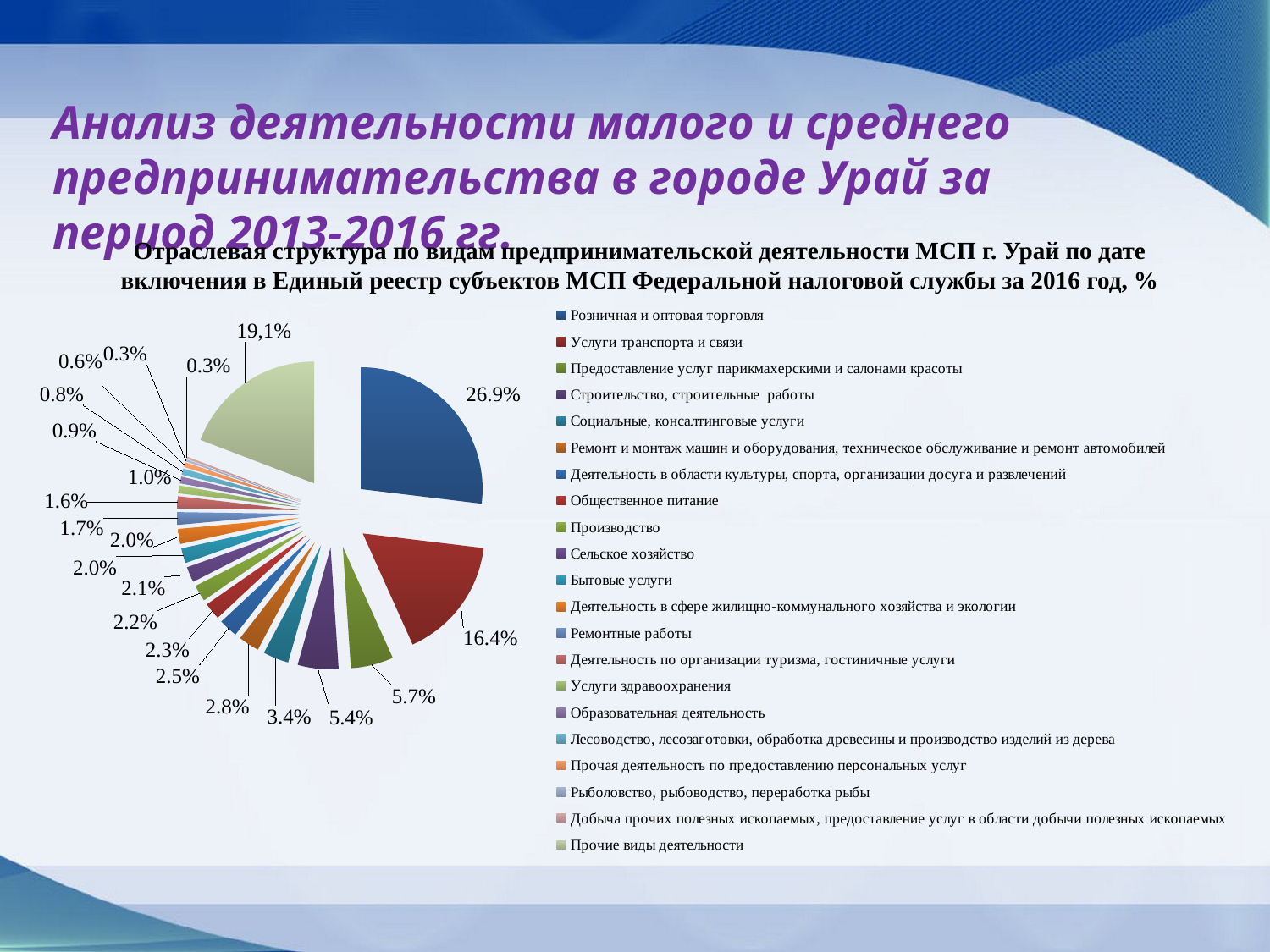
Which is larger: the slice for "Услуги транспорта и связи" or the slice for "Прочие виды деятельности"? Прочие виды деятельности What is the difference in percentage points between the slices for "Розничная и оптовая торговля" and "Услуги транспорта и связи"? 10.5 What share of the pie does "Строительство, строительные работы" have? 5.4% What share of the pie does "Услуги транспорта и связи" have? 16.4% How many categories does the legend of the pie chart list? 21 What kind of chart is shown on the slide? pie chart Which category has the largest slice of the pie? Розничная и оптовая торговля Which is larger: the slice for "Социальные, консалтинговые услуги" or the slice for "Строительство, строительные работы"? Строительство, строительные работы What share of the pie does "Розничная и оптовая торговля" have? 26.9% What is the smallest data label shown on the pie chart? 0.3% What share of the pie does "Прочие виды деятельности" have? 19,1% What share of the pie does "Предоставление услуг парикмахерскими и салонами красоты" have? 5.7%